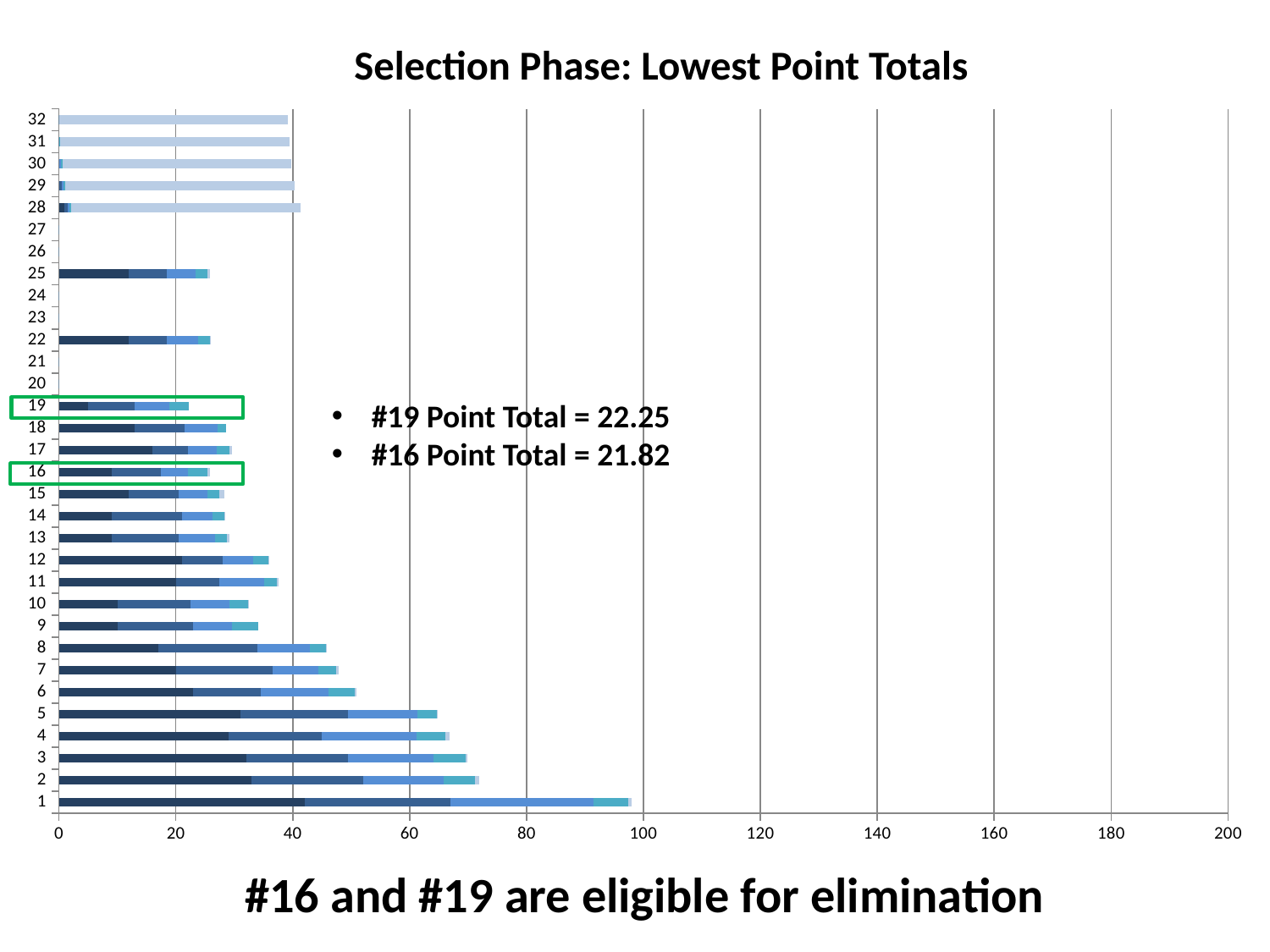
How many categories are listed on the vertical axis of the chart? 32 What kind of chart is shown on the slide? bar chart What is the point total for #19 according to the slide? 22.25 Is the total bar length for category 1 greater or less than 80? greater Is the total bar length for category 12 greater or less than 40? less What is the point total for #16 according to the slide? 21.82 What is the title of the chart? Selection Phase: Lowest Point Totals Is the total bar length for category 5 greater or less than 80? less What is the difference between the point totals of #19 and #16? 0.43 Which two categories are outlined with green boxes on the chart? 16 and 19 Which has the larger point total, #19 or #16? #19 Which category has the longest bar in the chart? 1